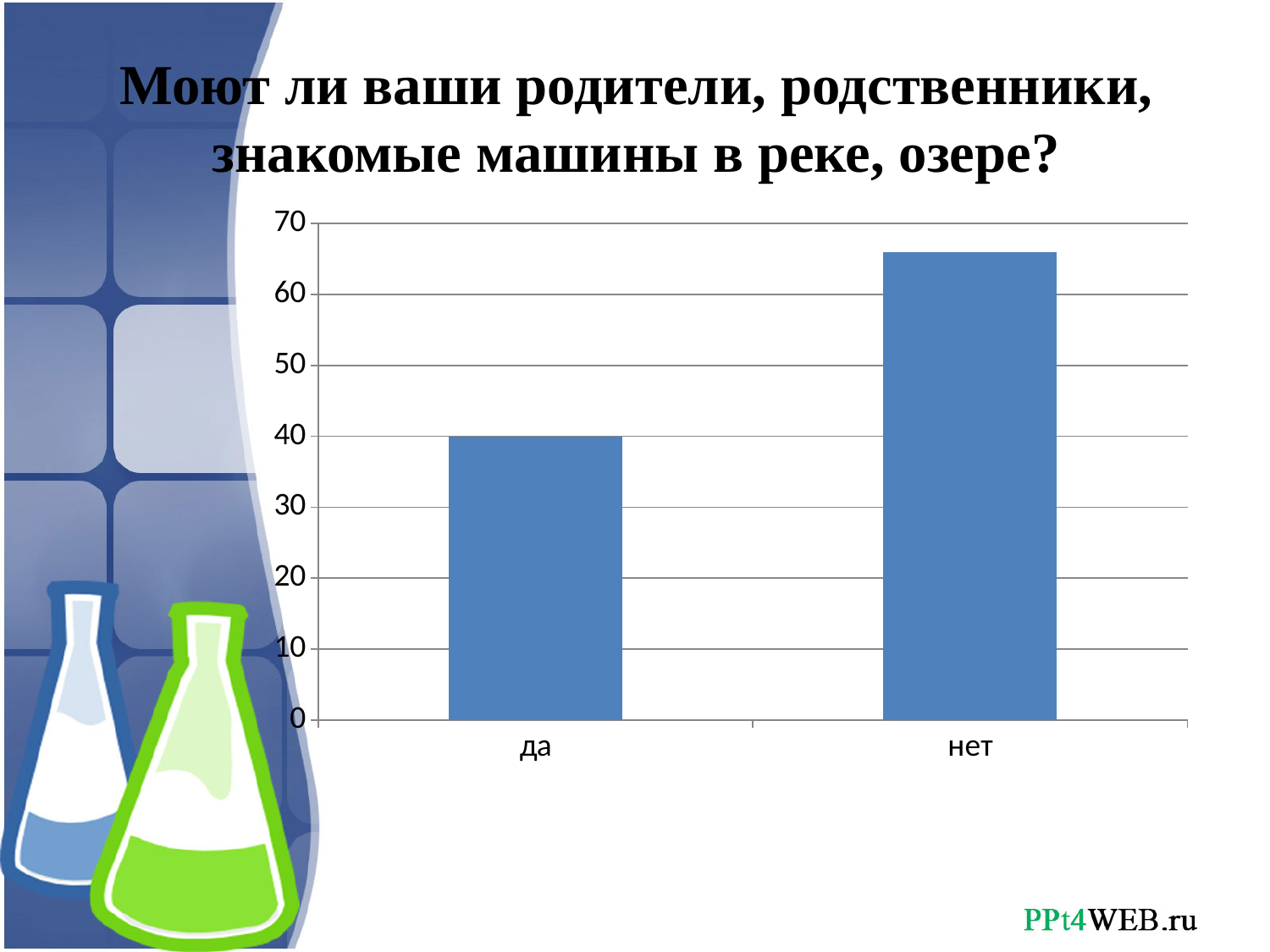
What is the value for "да"? 40 Is the value for "нет" greater or less than 60? greater Which category has the lowest bar? да Which category has the highest bar? нет Do the bar values rise or fall from left to right along the x axis? rise Is the value for "да" greater or less than 50? less What are the two category labels on the x axis? да, нет Which is larger, the value for "да" or the value for "нет"? нет Is the value for "нет" greater or less than 70? less What kind of chart is shown on the slide? bar chart What is the maximum value shown on the vertical axis? 70 How many categories are shown on the x axis of the chart? 2